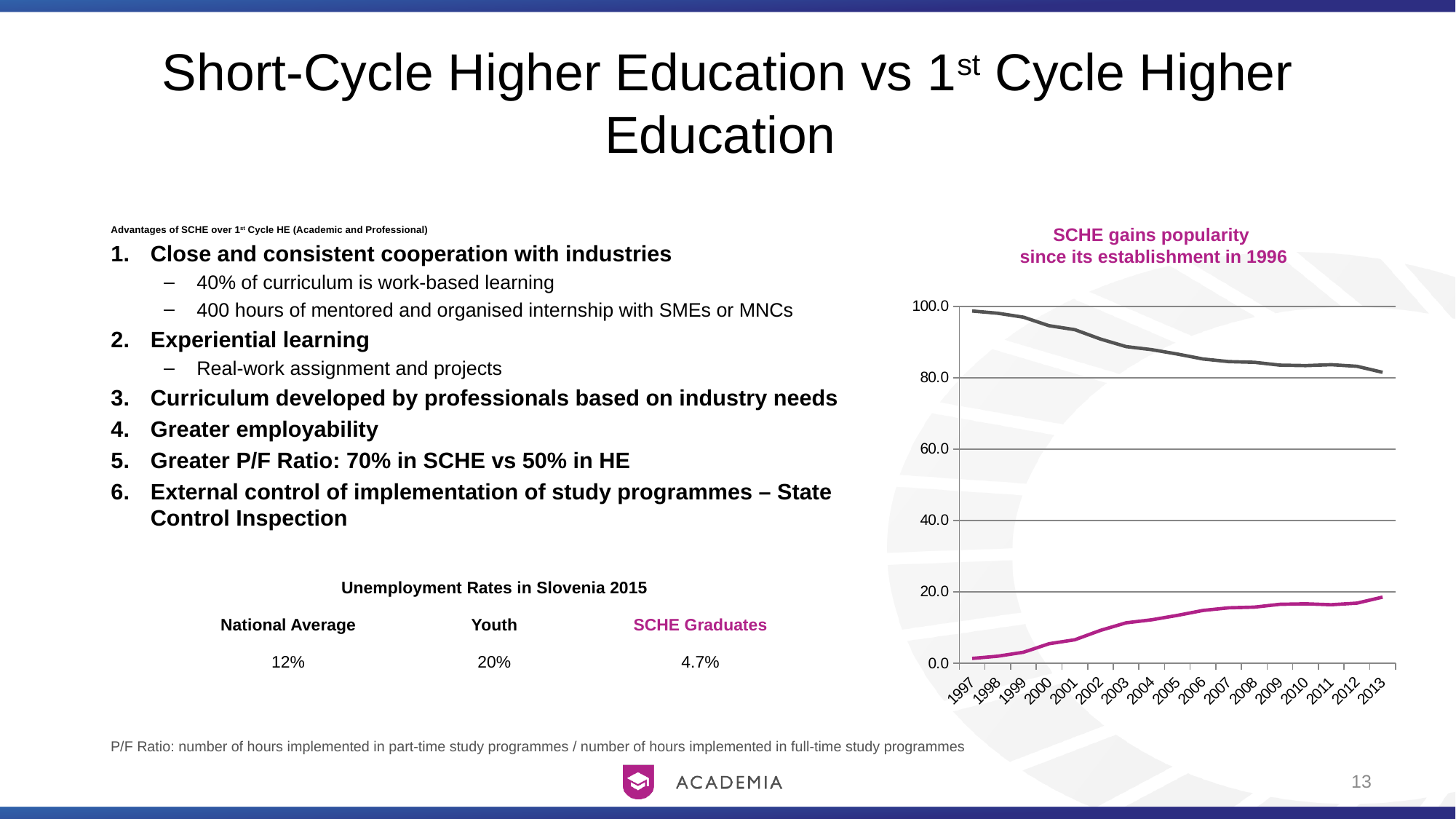
How many years are shown on the x axis of the chart? 17 In 2013, which line has the higher value, the grey line or the magenta line? grey line Is the value of the magenta line in 1997 greater or less than 20.0? less How many lines are plotted on the chart? 2 Is the value of the grey line in 1997 greater or less than 80.0? greater What is the first year shown on the x axis of the chart? 1997 Does the grey line rise or fall from 1997 to 2013? fall Does the magenta line rise or fall from 1997 to 2013? rise What kind of chart is shown on the right side of the slide? line chart Is the value of the grey line in 2005 greater or less than 60.0? greater What is the title of the chart on the right side of the slide? SCHE gains popularity since its establishment in 1996